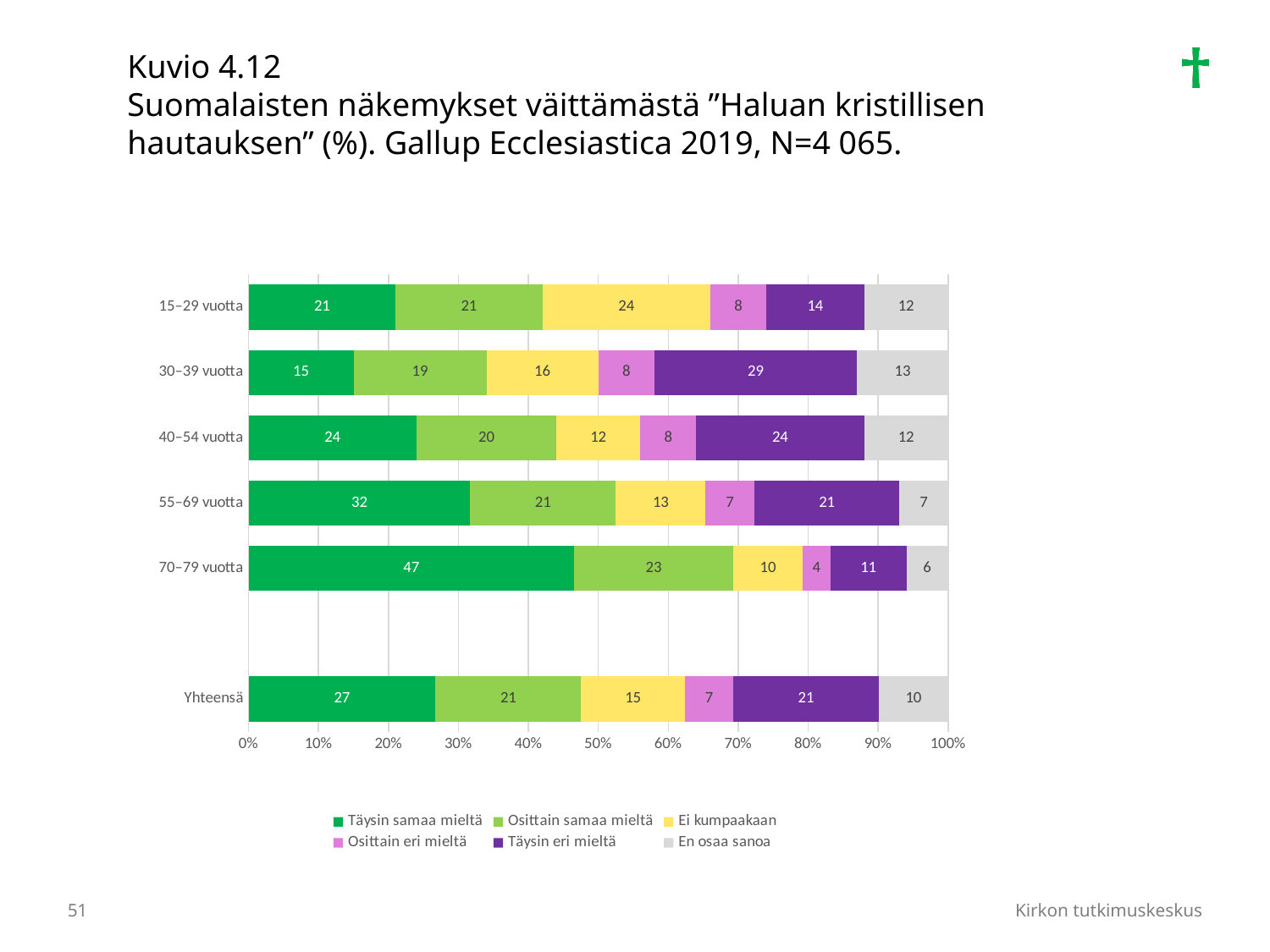
What kind of chart is shown on the slide? Stacked bar chart How many series does the legend list? 6 Which is larger: "Täysin eri mieltä" for 40–54 vuotta or for 55–69 vuotta? 40–54 vuotta What is the total of the "Täysin samaa mieltä" and "Osittain samaa mieltä" segments for the 55–69 vuotta bar? 53 What is the value of "En osaa sanoa" for the Yhteensä bar? 10 What is the difference between the "Täysin samaa mieltä" values for the 70–79 vuotta and 15–29 vuotta groups? 26 What is the value of "Täysin samaa mieltä" for the 70–79 vuotta group? 47 Which age group has the highest value for "Täysin samaa mieltä"? 70–79 vuotta Which age group has the lowest value for "Täysin samaa mieltä"? 30–39 vuotta Which legend entry is shown in grey? En osaa sanoa What is the value of "Täysin eri mieltä" for the 30–39 vuotta group? 29 How many bars (categories) are shown in the chart? 6